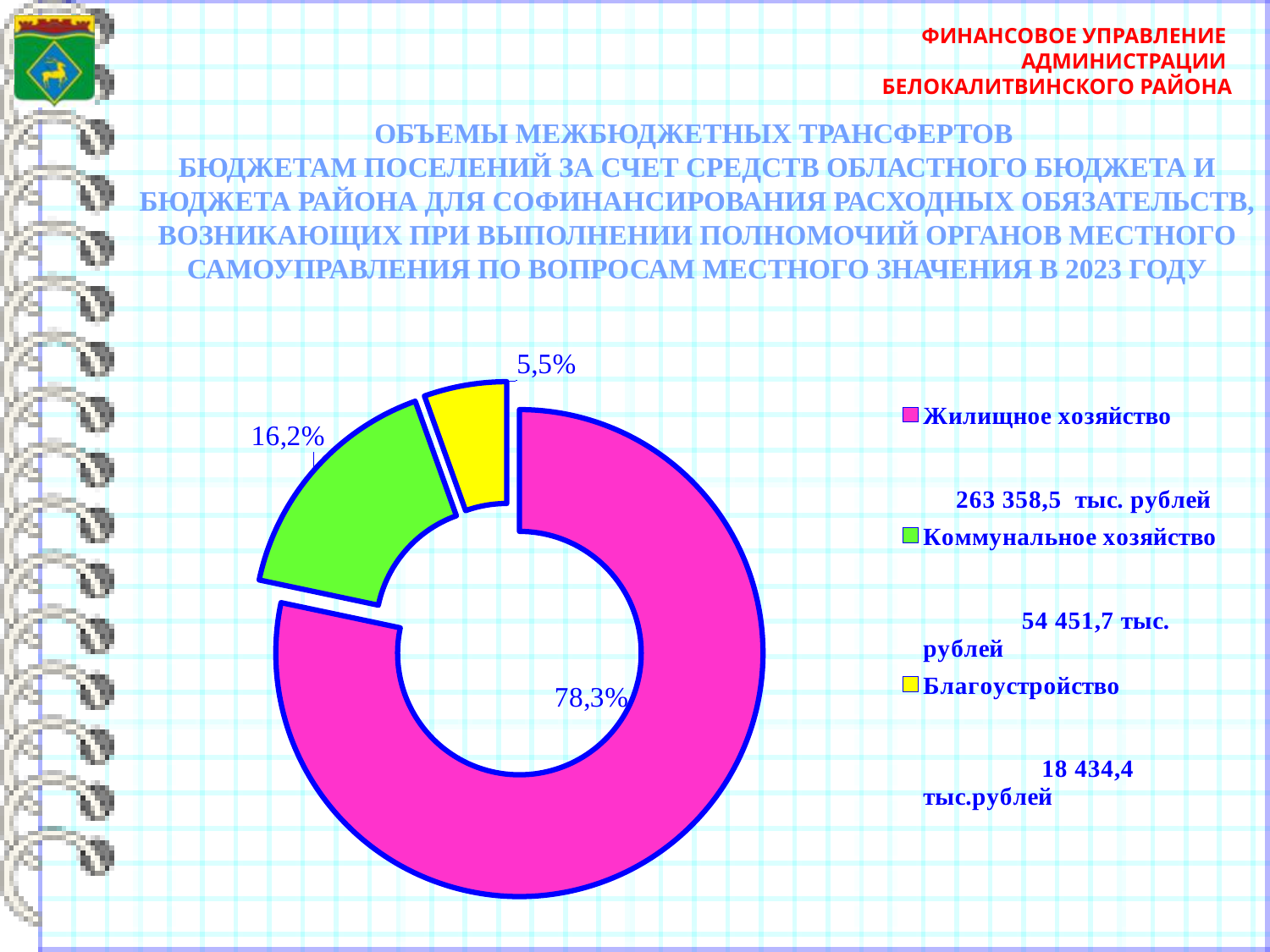
What type of chart is shown on the slide? Doughnut (pie) chart What share of the doughnut chart does Благоустройство take? 5,5% How many categories are shown in the chart? 3 What share of the doughnut chart does Коммунальное хозяйство take? 16,2% Which slice is larger: Коммунальное хозяйство or Благоустройство? Коммунальное хозяйство What amount in тыс. рублей is shown in the legend for Жилищное хозяйство? 263 358,5 тыс. рублей What amount in тыс. рублей is shown in the legend for Коммунальное хозяйство? 54 451,7 тыс. рублей Which category has the largest slice of the chart? Жилищное хозяйство What amount in тыс. рублей is shown in the legend for Благоустройство? 18 434,4 тыс. рублей Which category has the smallest slice of the chart? Благоустройство What is the difference in percentage points between the Жилищное хозяйство slice and the Коммунальное хозяйство slice? 62,1 What share of the doughnut chart does Жилищное хозяйство take? 78,3%